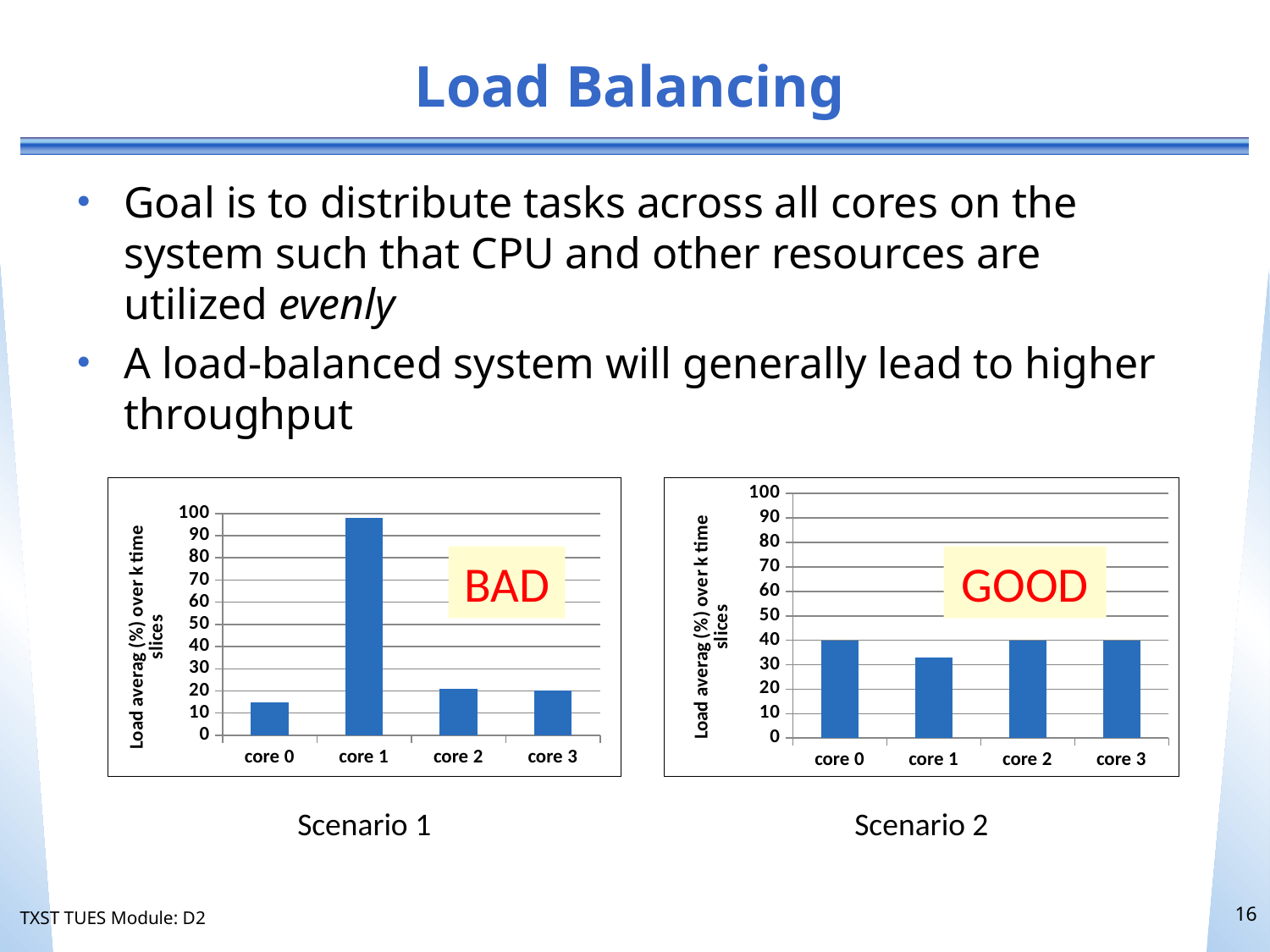
How many cores are shown on the x axis of the Scenario 2 chart? 4 In the Scenario 2 chart, is the value for core 3 greater or less than 30? greater In the Scenario 1 chart, is the value for core 1 greater or less than 90? greater In the Scenario 1 chart, which core has the lowest load average? core 0 What word is written in the box inside the Scenario 1 chart? BAD In the Scenario 1 chart, is the value for core 0 greater or less than 20? less In the Scenario 1 chart, which is larger, the value for core 1 or the value for core 2? core 1 In the Scenario 1 chart, which core has the highest load average? core 1 In the Scenario 2 chart, which core has the lowest load average? core 1 What kind of chart is the Scenario 1 chart? bar chart What is the y-axis label of the Scenario 2 chart? Load averag (%) over k time slices